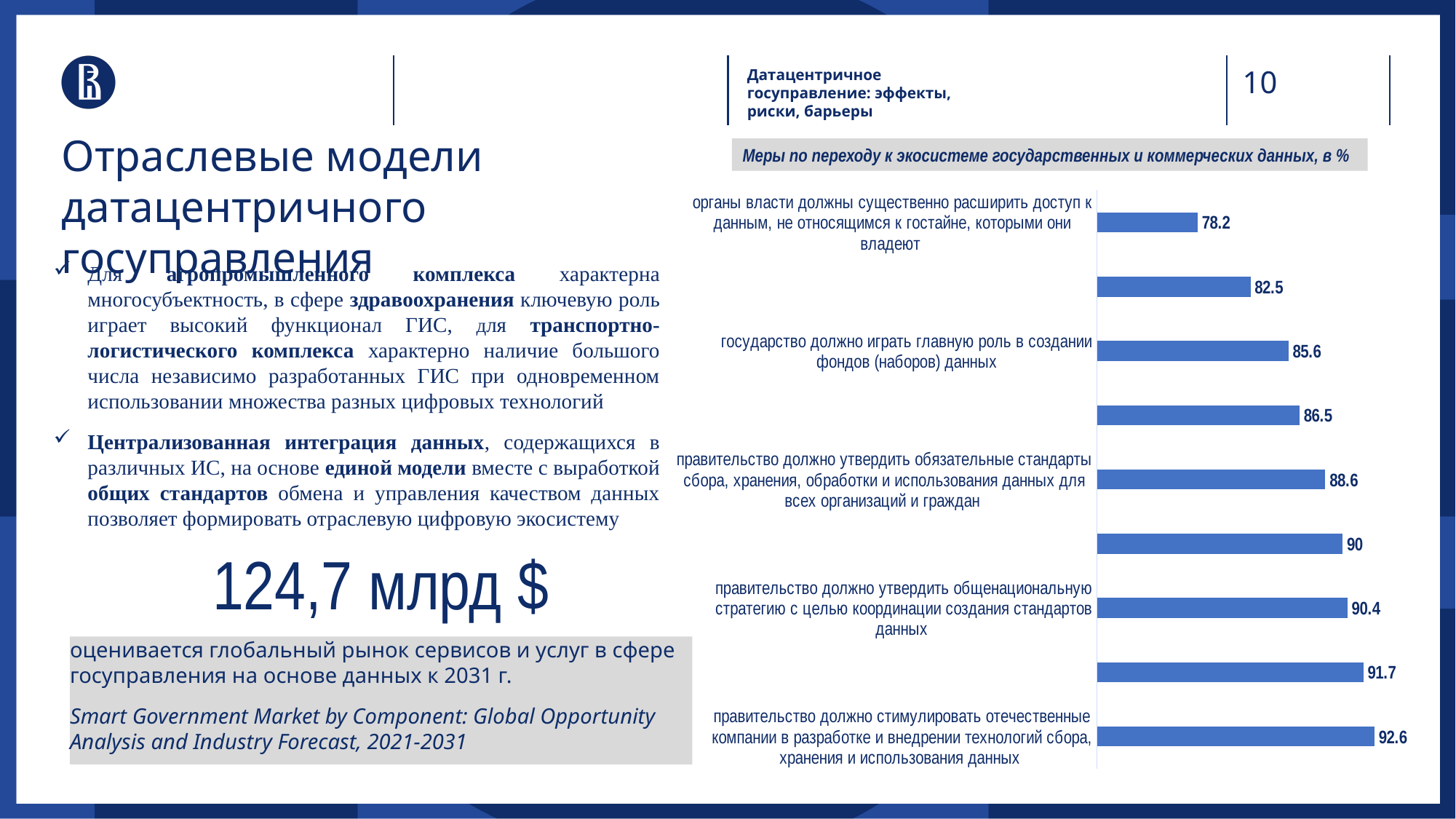
What is the value for the measure "правительство должно утвердить общенациональную стратегию с целью координации создания стандартов данных"? 90.4 What is the value for the measure "органы власти должны существенно расширить доступ к данным, не относящимся к гостайне, которыми они владеют"? 78.2 What is the value for the measure "государство должно играть главную роль в создании фондов (наборов) данных"? 85.6 Which measure has the lowest value in the chart? органы власти должны существенно расширить доступ к данным, не относящимся к гостайне, которыми они владеют What is the value for the measure "правительство должно утвердить обязательные стандарты сбора, хранения, обработки и использования данных для всех организаций и граждан"? 88.6 Which is larger: the value for "государство должно играть главную роль в создании фондов (наборов) данных" or the value for "правительство должно утвердить общенациональную стратегию с целью координации создания стандартов данных"? правительство должно утвердить общенациональную стратегию с целью координации создания стандартов данных How many bars are plotted in the chart? 9 What is the value for the measure "правительство должно стимулировать отечественные компании в разработке и внедрении технологий сбора, хранения и использования данных"? 92.6 What is the difference between the highest value (92.6) and the lowest value (78.2) in the chart? 14.4 Which measure has the highest value in the chart? правительство должно стимулировать отечественные компании в разработке и внедрении технологий сбора, хранения и использования данных What type of chart is shown on the slide? bar chart What is the title of the chart on the slide? Меры по переходу к экосистеме государственных и коммерческих данных, в %